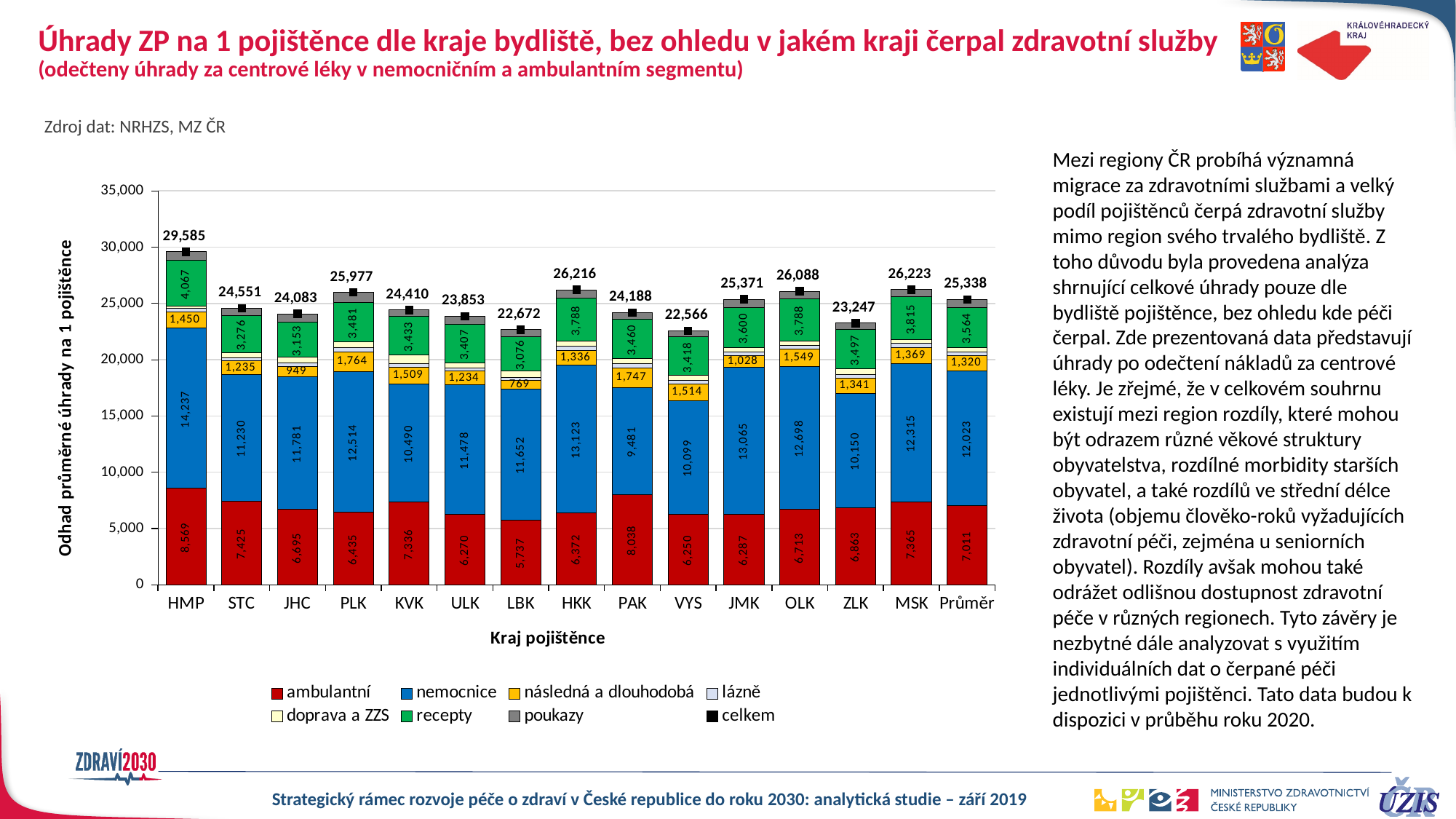
What is the nemocnice value for HKK? 13,123 What is the recepty value for Průměr? 3,564 Which category has the lowest total (celkem) value? VYS Which is larger, the nemocnice value for PLK or the nemocnice value for OLK? OLK Is the total value for LBK greater or less than 25,000? less Which category has the highest total (celkem) value? HMP How many categories are shown on the x axis? 15 How many series does the legend list? 8 What is the difference between the total for HMP and the total for Průměr? 4,247 What is the ambulantní value for PAK? 8,038 What is the total (celkem) value for HMP? 29,585 What kind of chart is shown on the slide? stacked bar chart